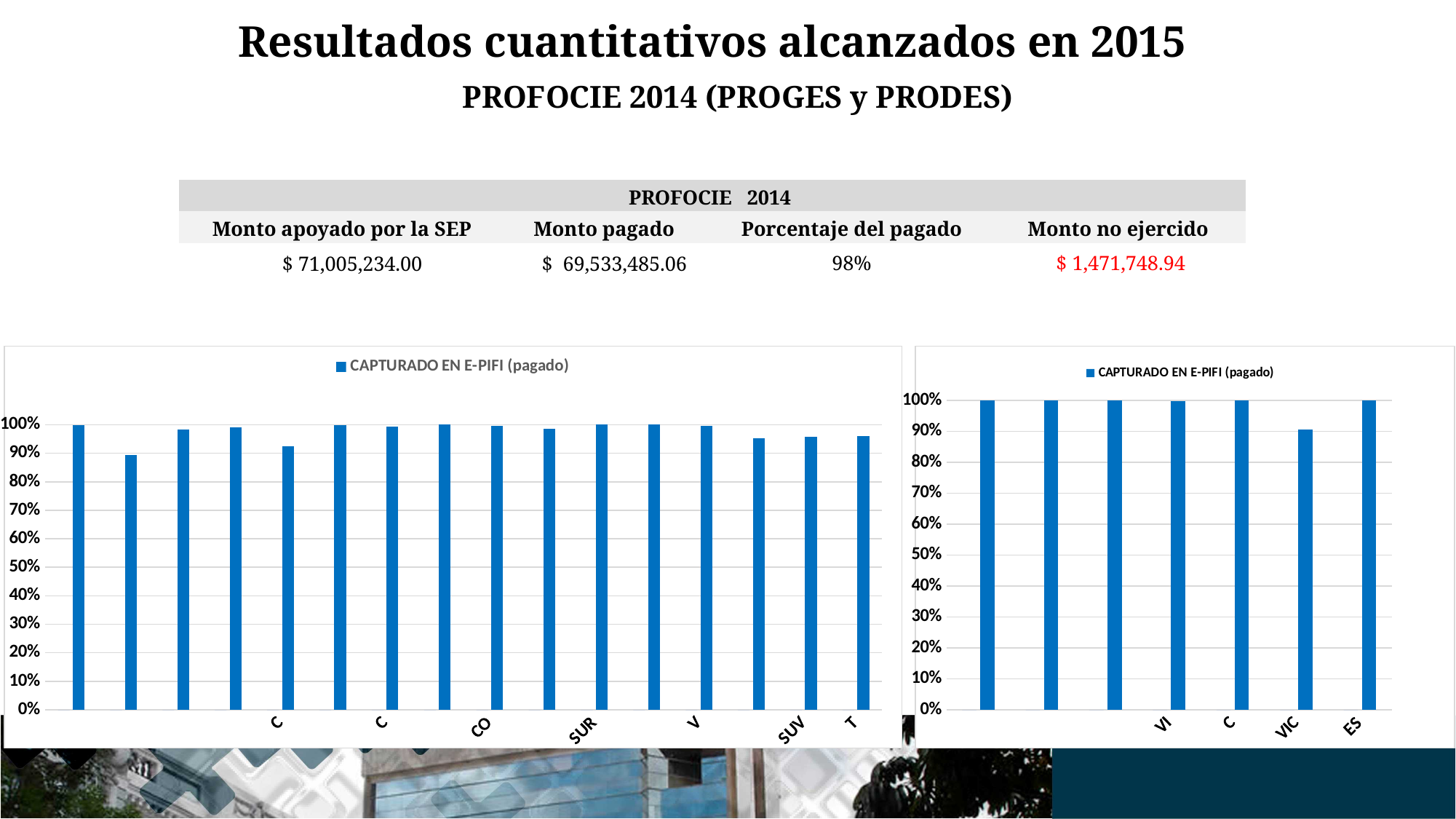
How many bars are plotted in the right chart? 7 What is the highest value shown on the vertical axis of the right chart? 100% What kind of chart is the chart on the right side of the slide? bar chart How many bars are plotted in the left chart? 16 In the right chart, which bar has the lowest value? the sixth bar from the left In the right chart, is the value of the sixth bar from the left greater or less than 100%? less In the right chart, is the value of the sixth bar from the left greater or less than 80%? greater What is the legend entry shown on the right chart? CAPTURADO EN E-PIFI (pagado) In the left chart, is the value of the second bar from the left greater or less than 100%? less How many series does the legend of the left chart list? 1 What kind of chart is the chart on the left side of the slide? bar chart